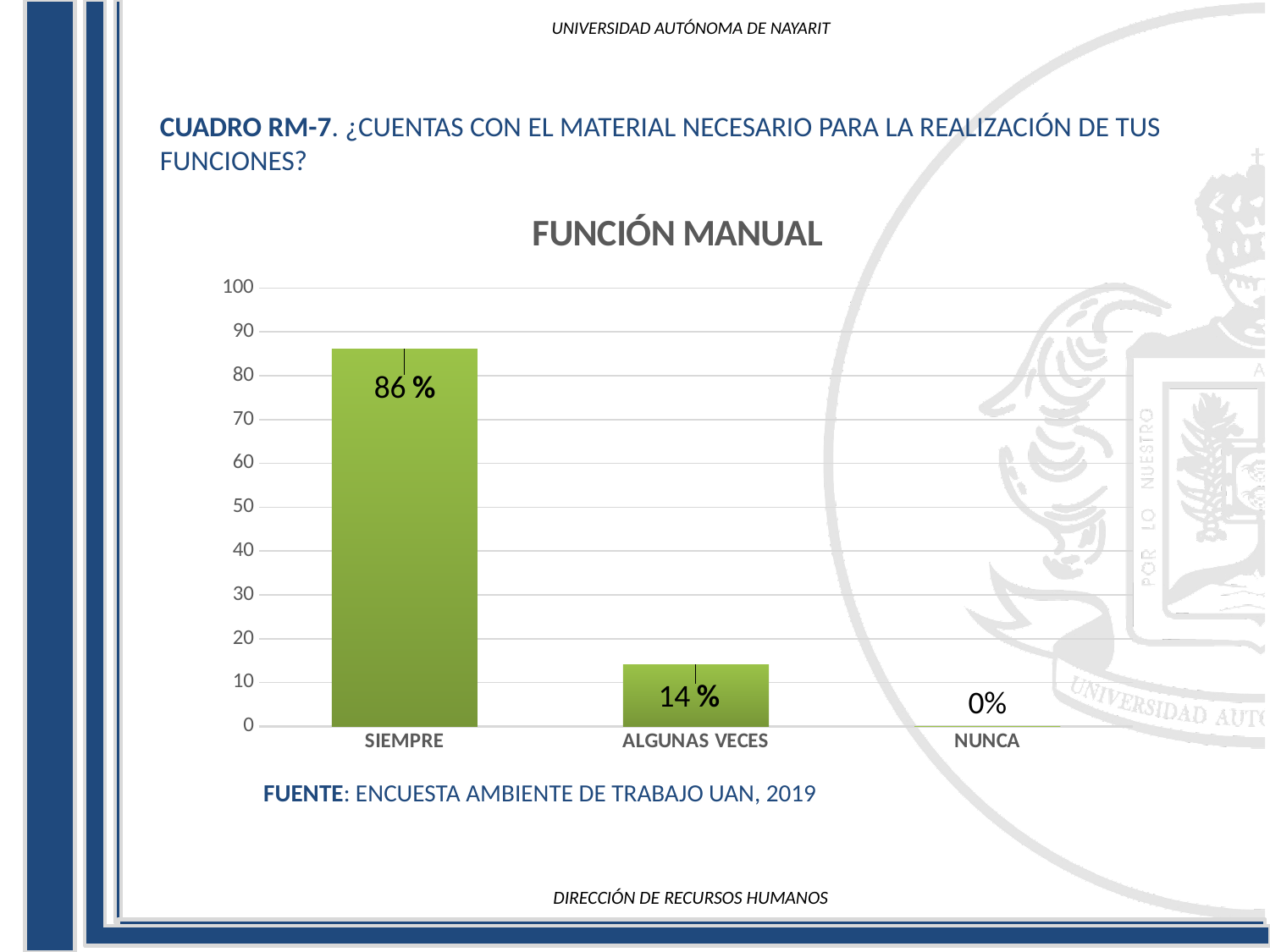
What is the value for SIEMPRE? 86 % What kind of chart is shown? bar chart Is the value for SIEMPRE greater or less than 80? greater What is the value for ALGUNAS VECES? 14 % What is the title of the chart? FUNCIÓN MANUAL How many categories are shown on the x axis? 3 Is the value for ALGUNAS VECES greater or less than 20? less Which category has the highest value? SIEMPRE What is the value for NUNCA? 0% What is the difference between the values for SIEMPRE and ALGUNAS VECES? 72 % Which category has the lowest value? NUNCA Which is larger, the value for ALGUNAS VECES or the value for NUNCA? ALGUNAS VECES